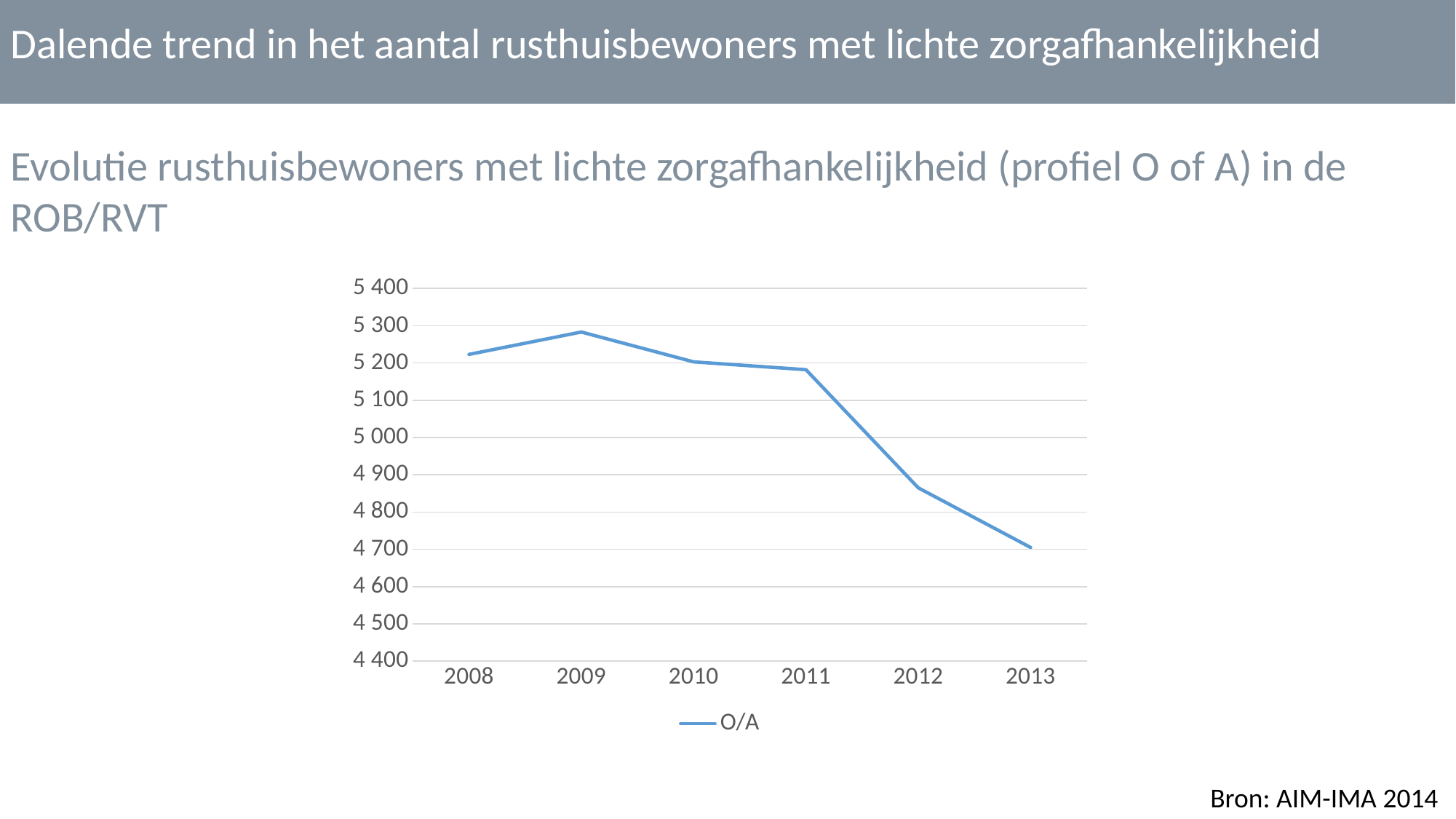
In which year is the O/A value lowest? 2013 What is the name of the series shown in the legend? O/A Is the O/A value for 2012 greater or less than 4 900? less Is the O/A value for 2013 greater or less than 4 800? less How many series does the chart's legend list? 1 Which year has the larger O/A value, 2008 or 2009? 2009 In which year is the O/A value highest? 2009 Does the O/A value rise or fall between 2011 and 2013? fall Which year has the larger O/A value, 2012 or 2013? 2012 What kind of chart is shown on the slide? line chart Is the O/A value for 2009 greater or less than 5 200? greater How many years are plotted on the x axis of the chart? 6